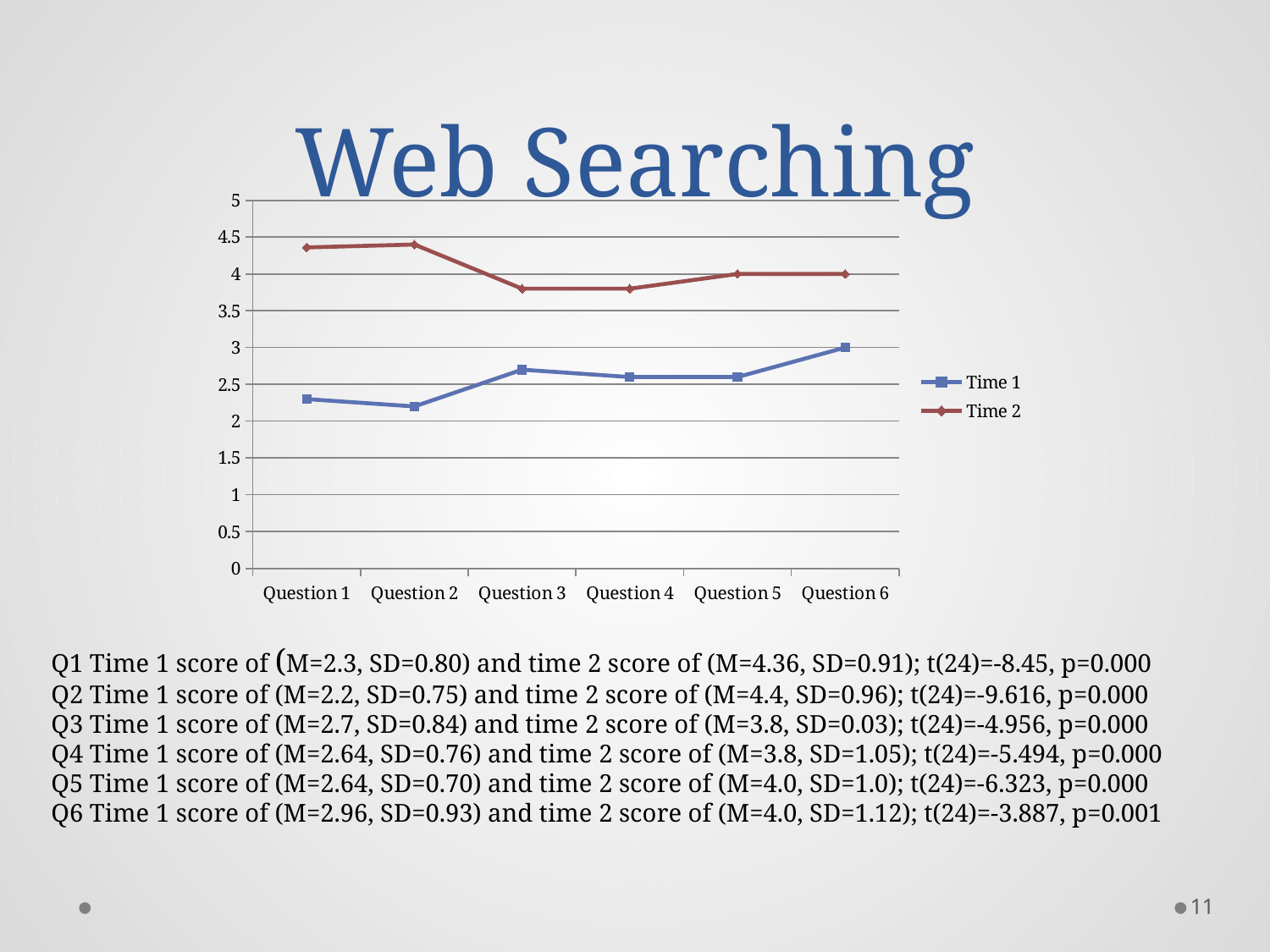
Which two series are listed in the legend? Time 1 and Time 2 For which question is the Time 1 value highest? Question 6 What is the Time 2 value for Question 6? 4 What is the Time 2 value for Question 5? 4 Is the Time 1 value for Question 1 greater or less than 2.5? less How many series does the legend list? 2 Is the Time 2 value for Question 3 greater or less than 4? less Is the Time 2 value for Question 1 greater or less than 4? greater What kind of chart is shown on the slide? line chart How many questions are shown along the x axis? 6 For Question 3, which series has the larger value, Time 1 or Time 2? Time 2 What is the title of the chart? Web Searching